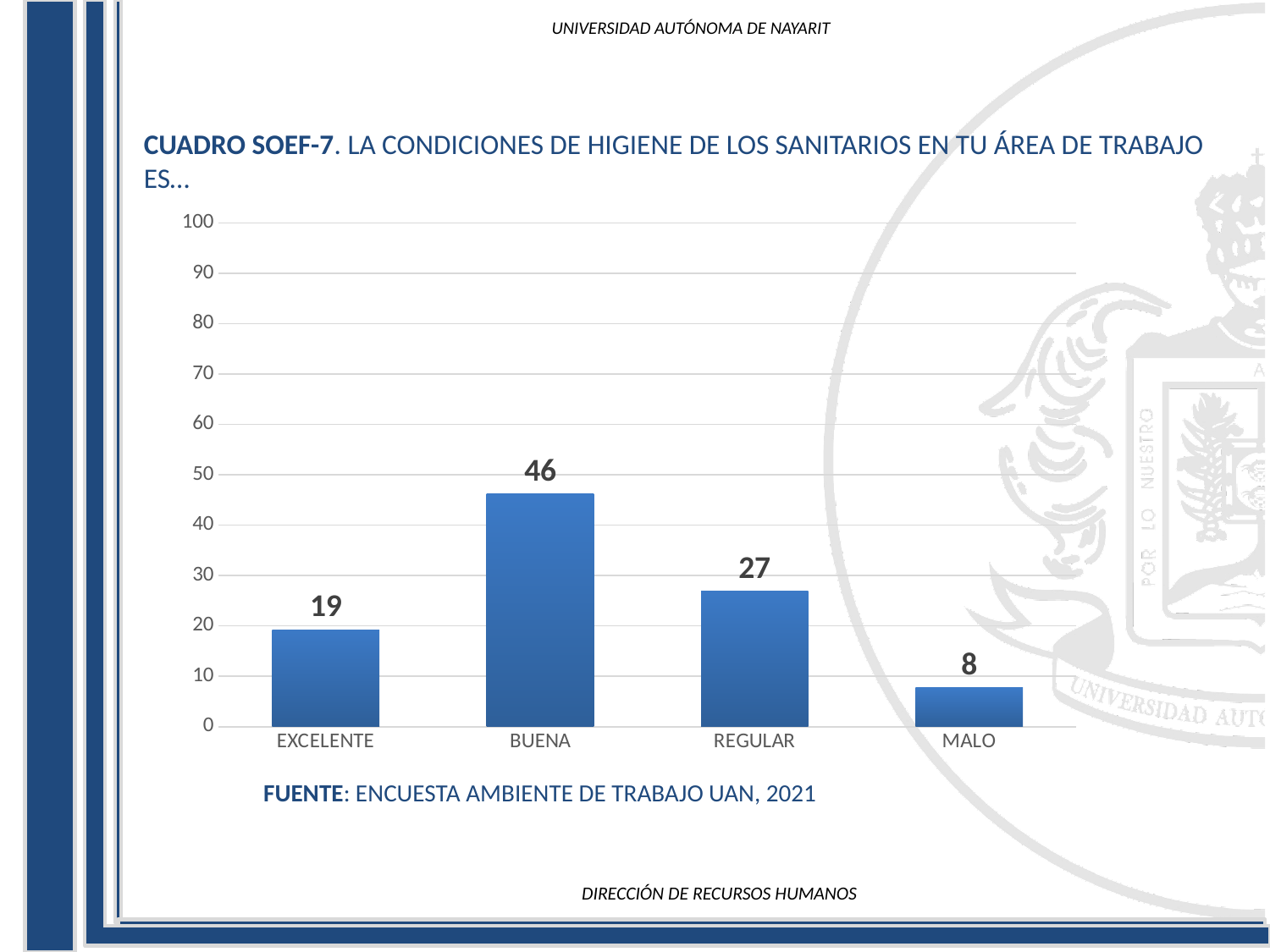
What is the value for BUENA? 46 What is the source cited below the chart? ENCUESTA AMBIENTE DE TRABAJO UAN, 2021 Which category has the highest value? BUENA What kind of chart is shown on the slide? bar chart What is the difference between the values for BUENA and REGULAR? 19 What is the value for MALO? 8 How many categories are shown on the x axis? 4 Is the value for BUENA greater or less than 40? greater What is the value for REGULAR? 27 What is the value for EXCELENTE? 19 Which is larger, the value for EXCELENTE or the value for REGULAR? REGULAR Which category has the lowest value? MALO